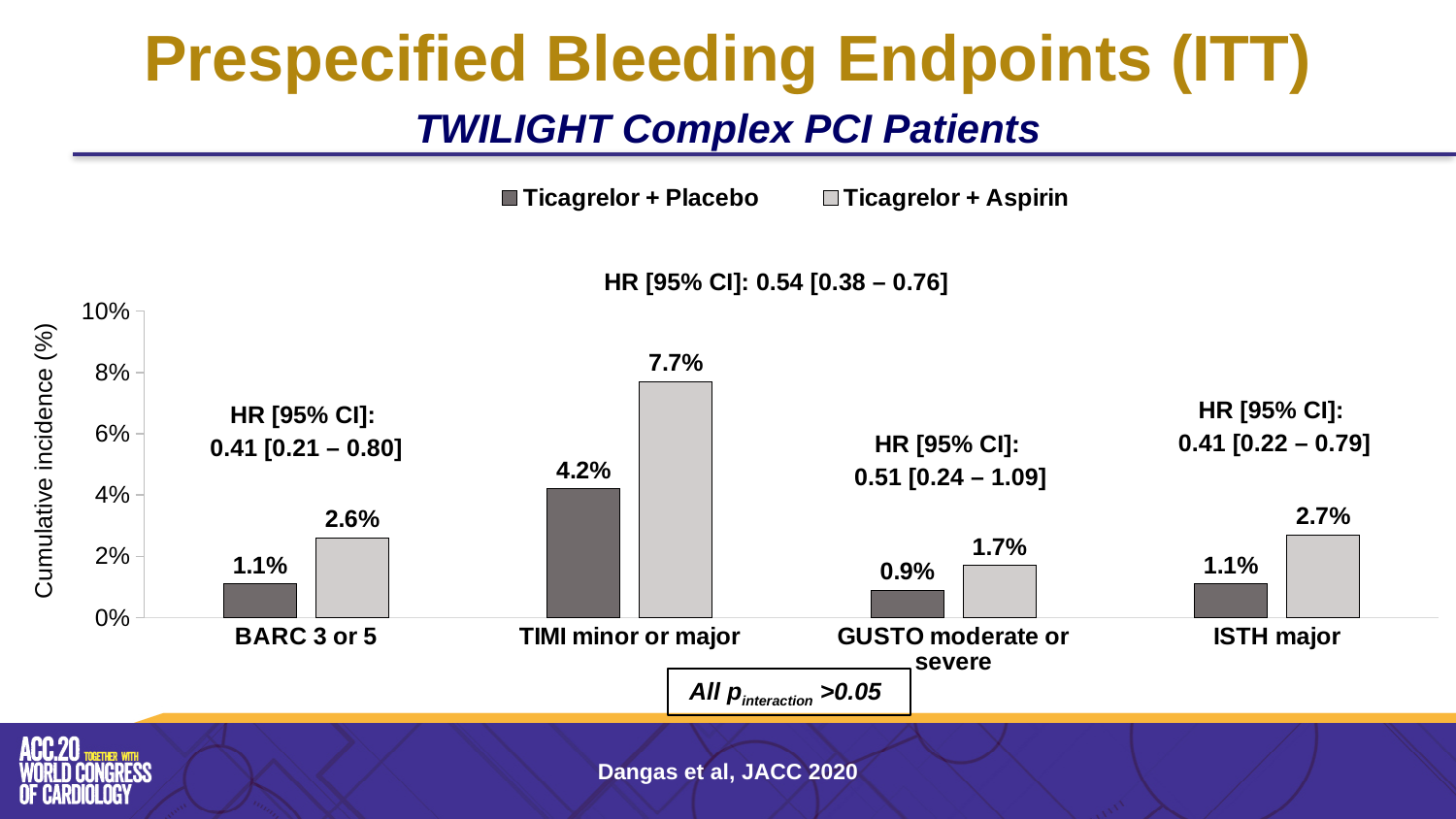
What kind of chart is shown on the slide? Bar chart In the BARC 3 or 5 category, which series has the larger cumulative incidence, Ticagrelor + Placebo or Ticagrelor + Aspirin? Ticagrelor + Aspirin What is the cumulative incidence for Ticagrelor + Aspirin in the TIMI minor or major category? 7.7% What is the HR [95% CI] shown above the TIMI minor or major bars? 0.54 [0.38 – 0.76] How many series does the legend list? 2 What is the cumulative incidence for Ticagrelor + Placebo in the BARC 3 or 5 category? 1.1% How many bleeding endpoint categories are shown on the x axis? 4 Which bleeding endpoint has the highest cumulative incidence for Ticagrelor + Aspirin? TIMI minor or major What is the difference between the Ticagrelor + Aspirin and Ticagrelor + Placebo values in the TIMI minor or major category? 3.5% What is the cumulative incidence for Ticagrelor + Placebo in the GUSTO moderate or severe category? 0.9% What is the cumulative incidence for Ticagrelor + Aspirin in the ISTH major category? 2.7% Which bleeding endpoint has the lowest cumulative incidence for Ticagrelor + Placebo? GUSTO moderate or severe